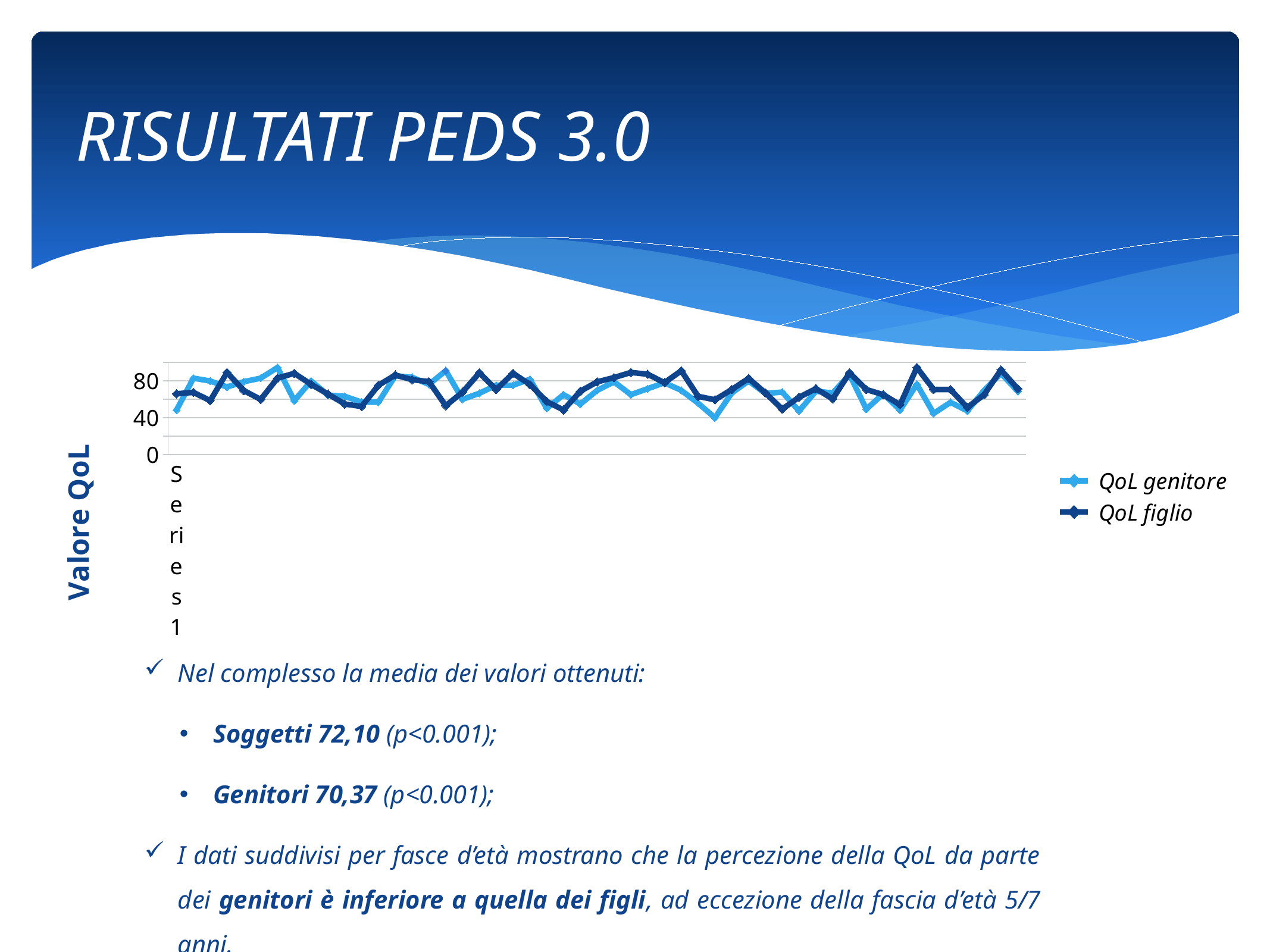
What kind of chart is shown on the slide? line chart Which series contains the single lowest point on the chart, QoL genitore or QoL figlio? QoL genitore Is the lowest value of the QoL figlio series greater or less than 40? greater How many series does the chart's legend list? 2 What is the title of the chart's vertical axis? Valore QoL Is the highest value of the QoL genitore series greater or less than 80? greater What are the two series named in the chart's legend? QoL genitore and QoL figlio